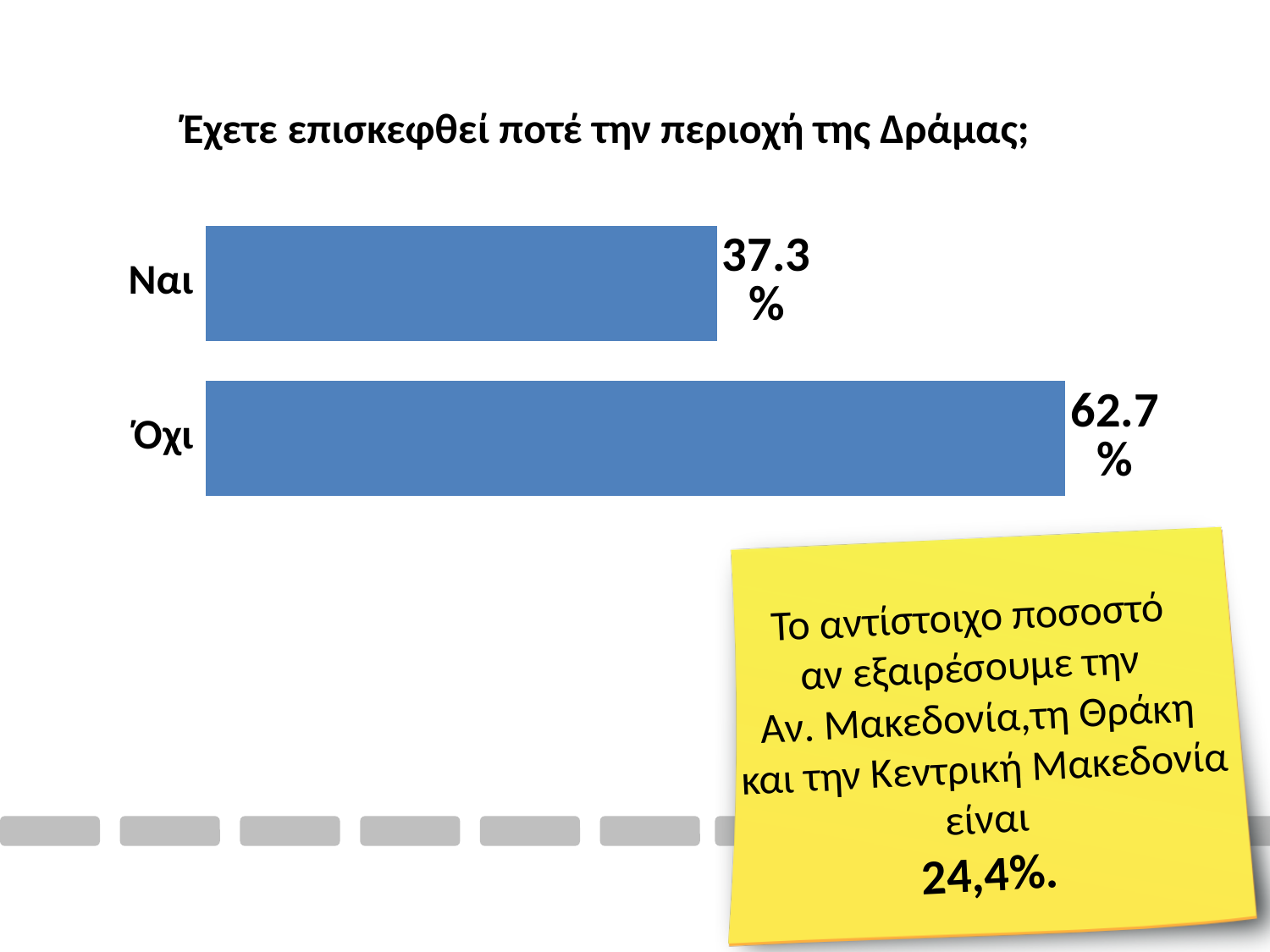
What is the total of the values for Ναι and Όχι? 100% What is the value for Όχι? 62.7% Which is larger, the value for Ναι or the value for Όχι? Όχι What kind of chart is shown on the slide? Bar chart What is the difference between the values for Όχι and Ναι? 25.4% What colour are the bars in the chart? Blue Which category has the highest value? Όχι What is the title of the chart? Έχετε επισκεφθεί ποτέ την περιοχή της Δράμας; How many categories are shown in the chart? 2 What is the value for Ναι? 37.3% Which category has the lowest value? Ναι